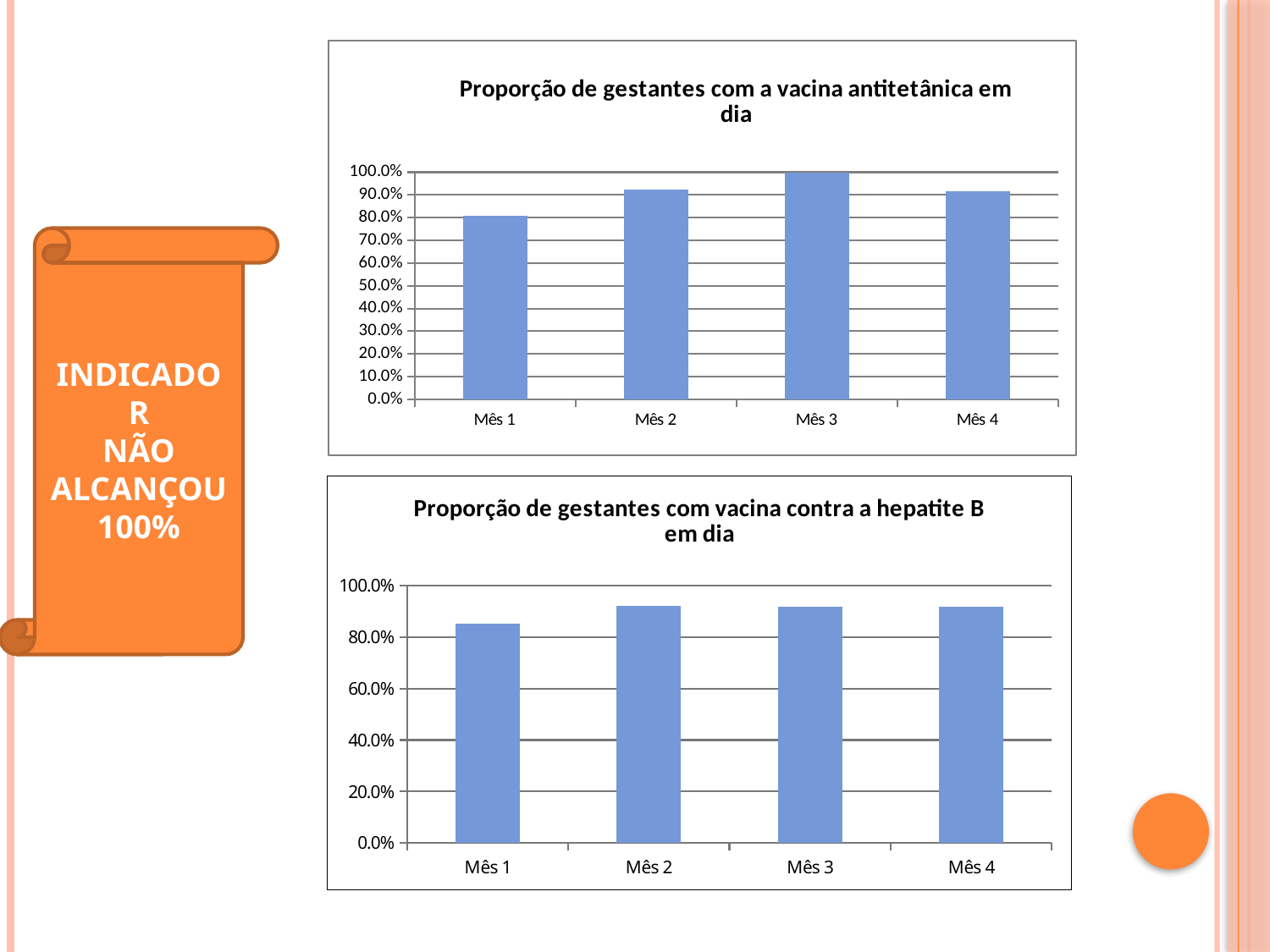
In the top chart (Proporção de gestantes com a vacina antitetânica em dia), is the value for Mês 1 greater or less than 70.0%? greater In the bottom chart (Proporção de gestantes com vacina contra a hepatite B em dia), is the value for Mês 2 greater or less than 100.0%? less In the top chart (Proporção de gestantes com a vacina antitetânica em dia), which is larger, the value for Mês 1 or the value for Mês 3? Mês 3 In the bottom chart (Proporção de gestantes com vacina contra a hepatite B em dia), is the value for Mês 1 greater or less than 80.0%? greater What kind of chart is the bottom chart (Proporção de gestantes com vacina contra a hepatite B em dia)? Bar chart In the top chart (Proporção de gestantes com a vacina antitetânica em dia), which month has the highest value? Mês 3 In the top chart (Proporção de gestantes com a vacina antitetânica em dia), which month has the lowest value? Mês 1 How many months are shown on the x axis of the top chart (Proporção de gestantes com a vacina antitetânica em dia)? 4 In the bottom chart (Proporção de gestantes com vacina contra a hepatite B em dia), which is larger, the value for Mês 1 or the value for Mês 2? Mês 2 In the bottom chart (Proporção de gestantes com vacina contra a hepatite B em dia), which month has the lowest value? Mês 1